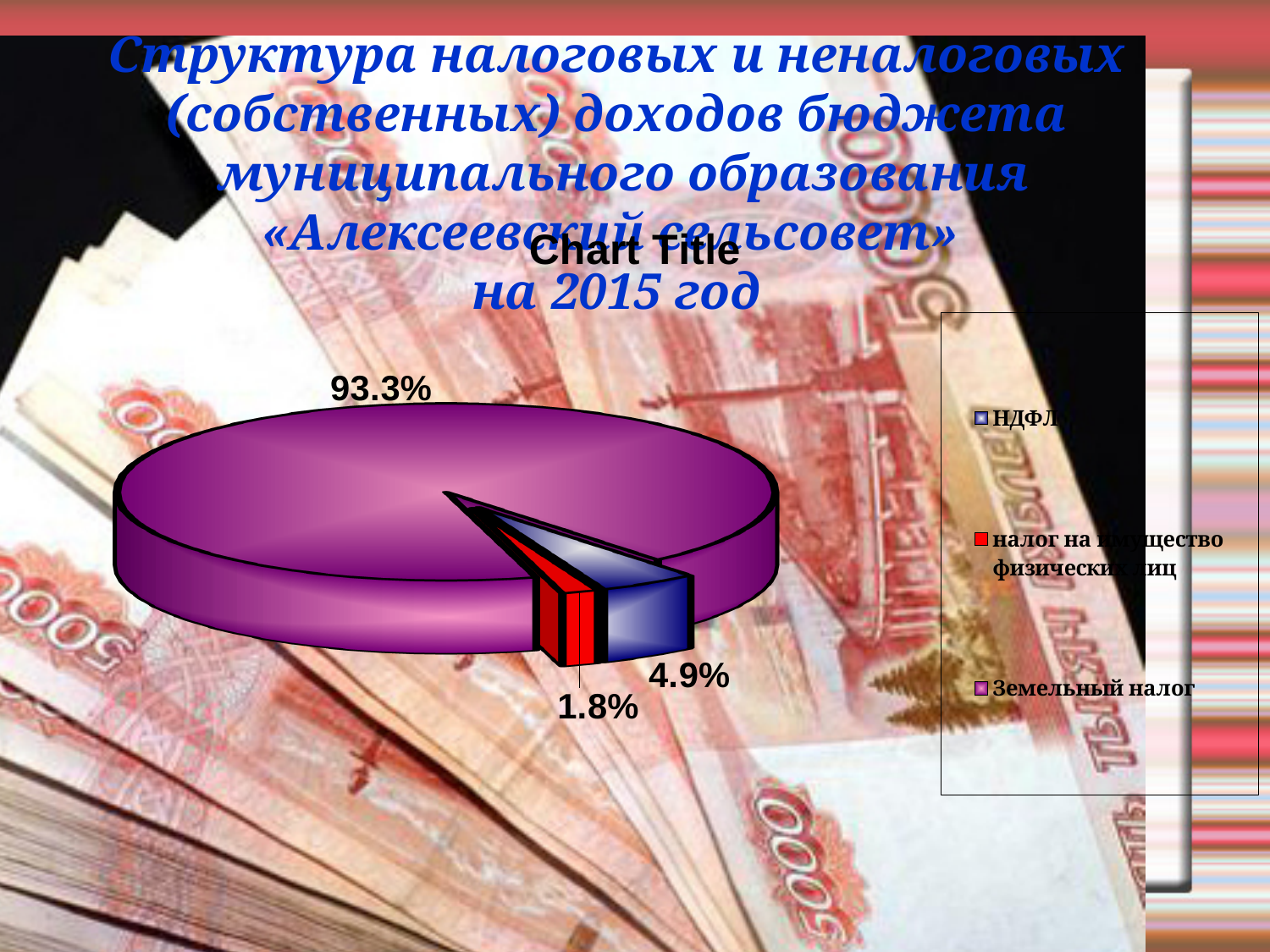
What is the difference between the share for Земельный налог and the share for НДФЛ? 88.4% How many slices does the pie chart have? 3 What share of the pie does Земельный налог have? 93.3% Which category has the largest slice of the pie? Земельный налог Which category has the smallest slice of the pie? налог на имущество физических лиц Which is larger, the share for НДФЛ or the share for налог на имущество физических лиц? НДФЛ What colour is the slice for Земельный налог in the pie chart? Purple What kind of chart is shown on the slide? Pie chart What share of the pie does налог на имущество физических лиц have? 1.8% What is the difference between the share for НДФЛ and the share for налог на имущество физических лиц? 3.1% What share of the pie does НДФЛ have? 4.9% How many entries does the legend of the pie chart list? 3